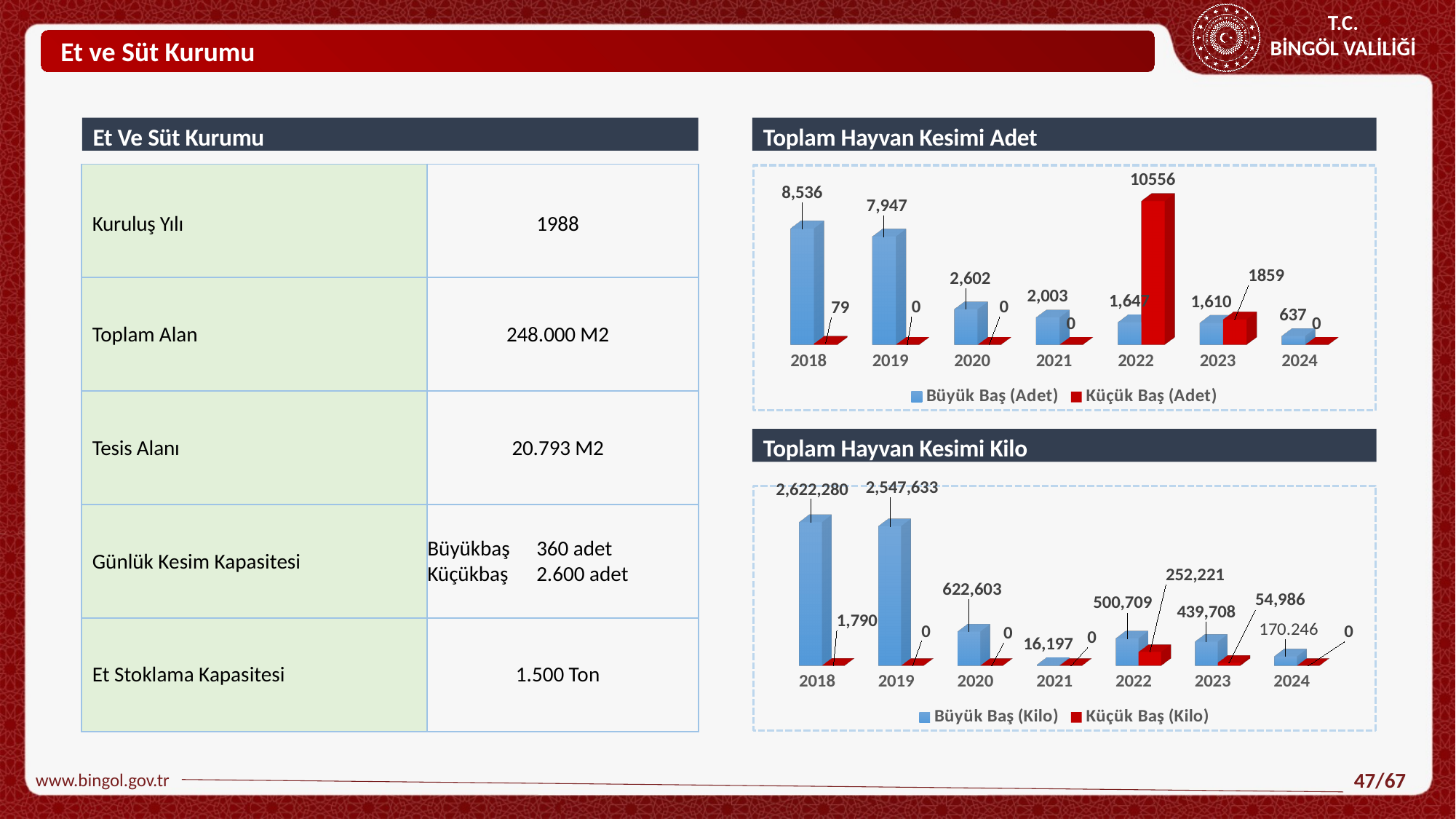
In the 'Toplam Hayvan Kesimi Adet' chart, what is the Küçük Baş (Adet) value for 2022? 10556 In the 'Toplam Hayvan Kesimi Adet' chart, how many series does the legend list? 2 In the 'Toplam Hayvan Kesimi Kilo' chart, what is the Küçük Baş (Kilo) value for 2023? 54,986 In the 'Toplam Hayvan Kesimi Adet' chart, how many years are shown on the x axis? 7 What kind of chart is 'Toplam Hayvan Kesimi Kilo'? Bar chart In the 'Toplam Hayvan Kesimi Kilo' chart, what is the Büyük Baş (Kilo) value for 2021? 16,197 In the 'Toplam Hayvan Kesimi Adet' chart, what is the Büyük Baş (Adet) value for 2018? 8,536 In the 'Toplam Hayvan Kesimi Adet' chart, which year has the lowest Büyük Baş (Adet) value? 2024 In the 'Toplam Hayvan Kesimi Adet' chart, what is the difference between the Büyük Baş (Adet) values for 2018 and 2019? 589 In the 'Toplam Hayvan Kesimi Adet' chart, what colour are the Küçük Baş (Adet) bars? Red In the 'Toplam Hayvan Kesimi Kilo' chart, which year has the highest Büyük Baş (Kilo) value? 2018 In the 'Toplam Hayvan Kesimi Kilo' chart, which is larger: the Büyük Baş (Kilo) value for 2022 or for 2023? 2022